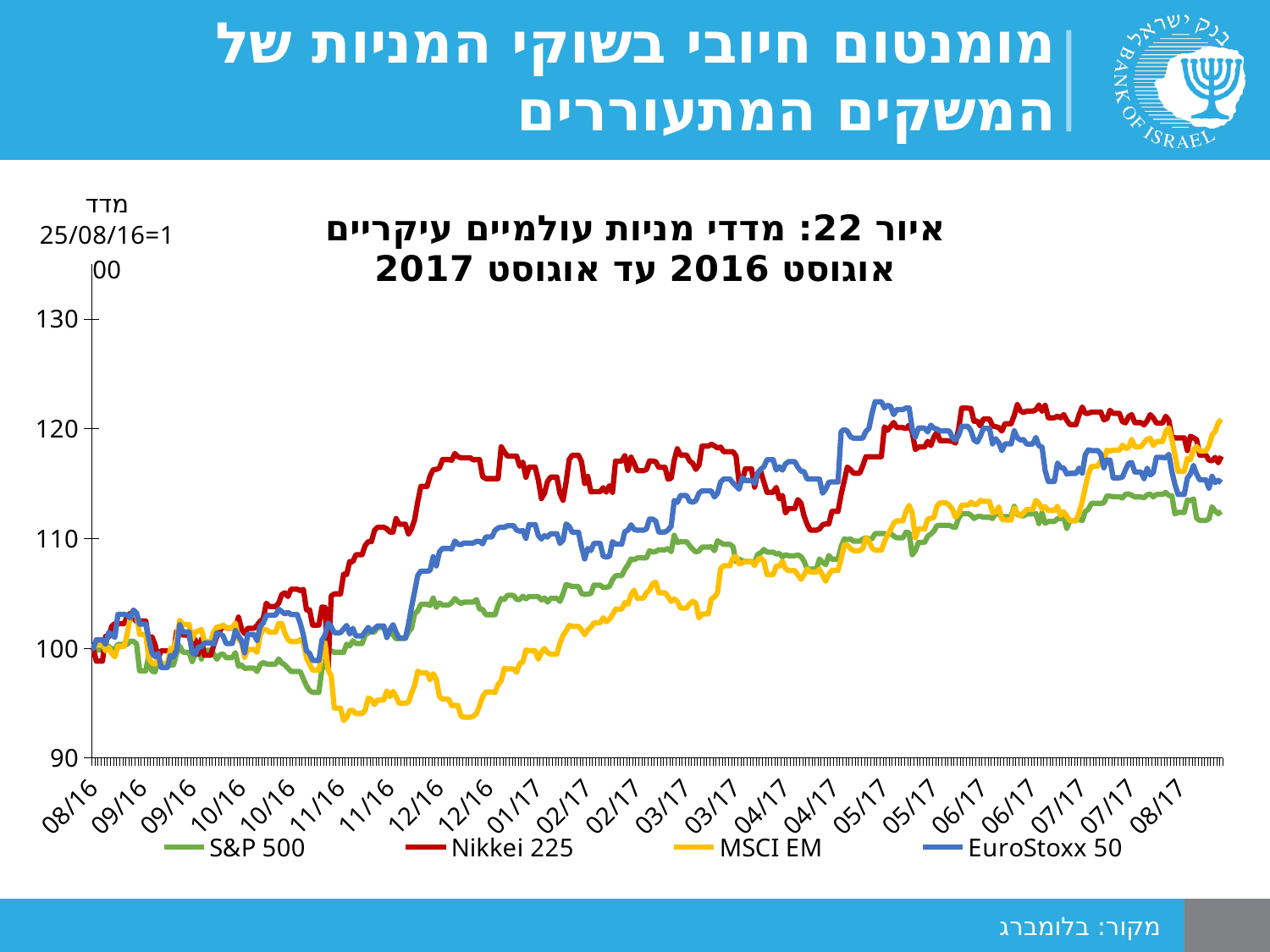
What kind of chart is shown on the slide? line chart Is the value of the S&P 500 at the end of the period (08/17) greater or less than 110? greater What base date is the index set to 100 on, according to the axis label? 25/08/16 Is the value of the Nikkei 225 at the end of the period (08/17) greater or less than 110? greater Which series dropped to the lowest level during the period shown? MSCI EM Overall, do the index values rise or fall from 08/16 to 08/17? rise Is the value of EuroStoxx 50 at the end of the period (08/17) greater or less than 120? less At the end of the period (08/17), which is higher: Nikkei 225 or S&P 500? Nikkei 225 Around 12/16, which is higher: S&P 500 or MSCI EM? S&P 500 How many series does the legend list? 4 Which series are listed in the legend? S&P 500, Nikkei 225, MSCI EM, EuroStoxx 50